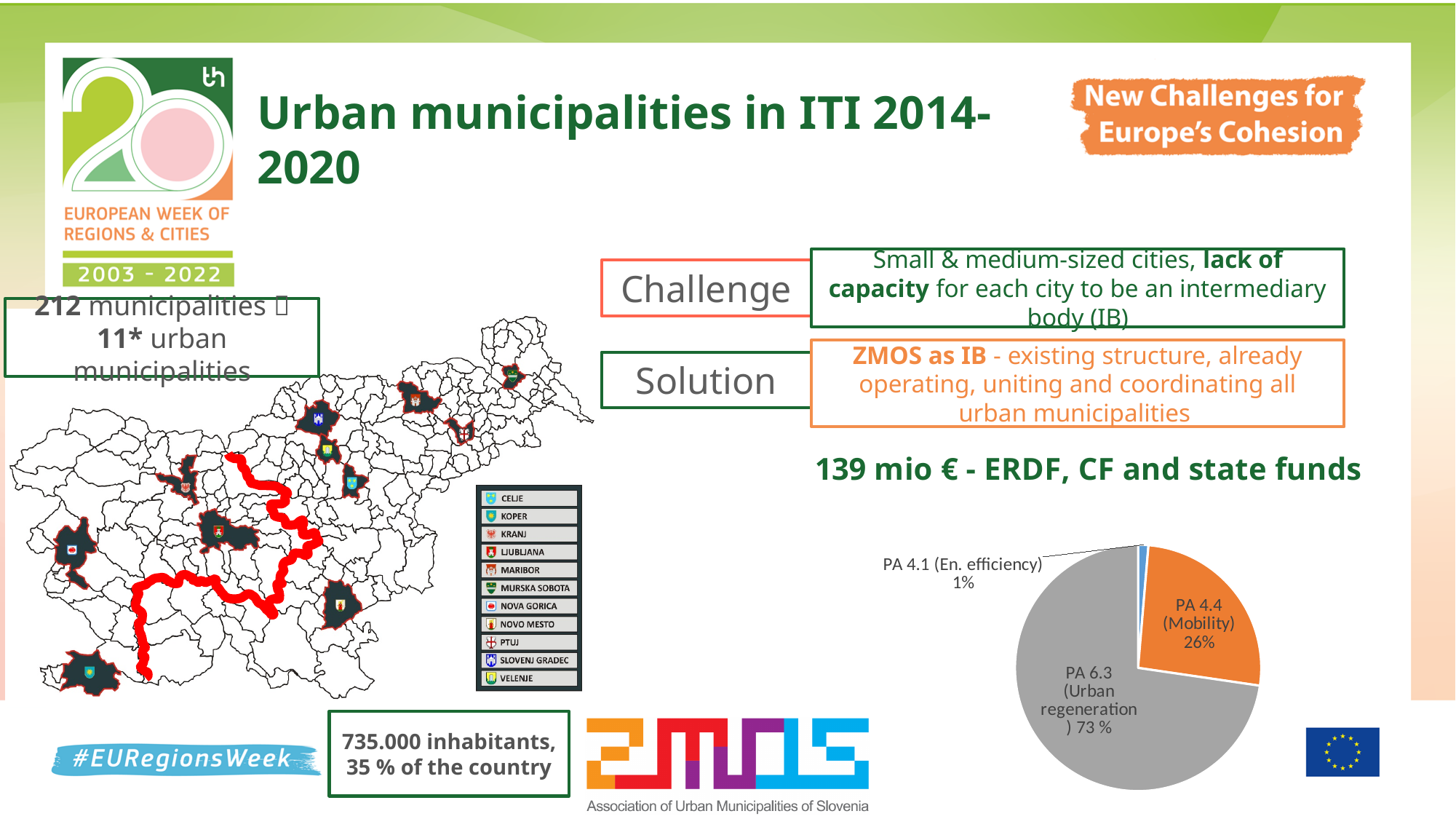
What colour is the PA 4.4 (Mobility) slice in the pie chart? orange In the pie chart, what is the difference in percentage points between PA 4.4 (Mobility) and PA 4.1 (En. efficiency)? 25 What share of the pie chart is PA 4.4 (Mobility)? 26% Which slice of the pie chart is the smallest? PA 4.1 (En. efficiency) What share of the pie chart is PA 6.3 (Urban regeneration)? 73 % Which slice of the pie chart is the largest? PA 6.3 (Urban regeneration) What share of the pie chart is PA 4.1 (En. efficiency)? 1% In the pie chart, which is larger: PA 4.4 (Mobility) or PA 4.1 (En. efficiency)? PA 4.4 (Mobility) What kind of chart is shown at the bottom right of the slide? pie chart In the pie chart, what is the difference in percentage points between PA 6.3 (Urban regeneration) and PA 4.4 (Mobility)? 47 How many slices does the pie chart have? 3 What colour is the PA 6.3 (Urban regeneration) slice in the pie chart? grey